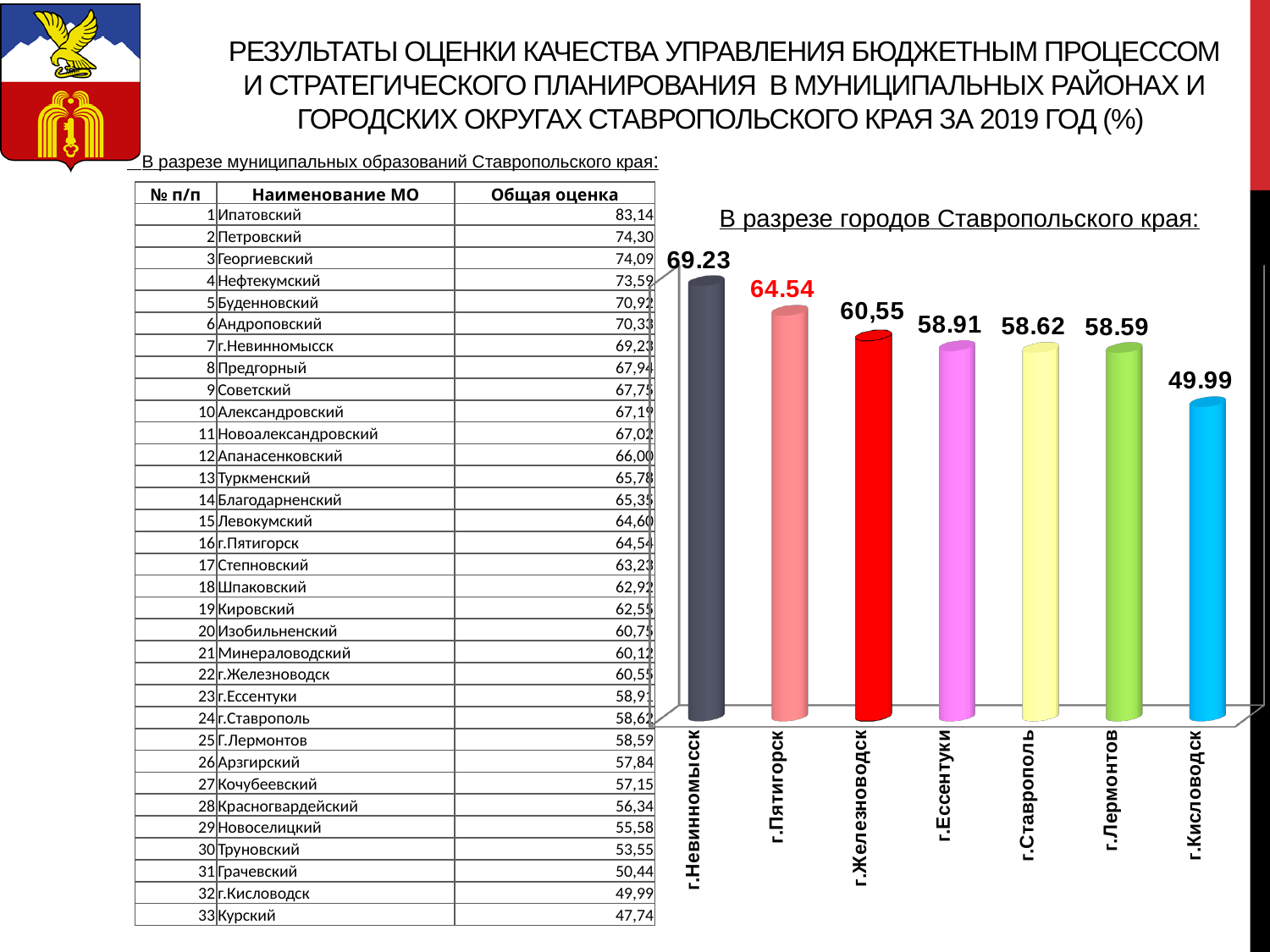
What is the value for г.Кисловодск? 49.99 Which is larger, the value for г.Пятигорск or the value for г.Железноводск? г.Пятигорск What is the difference between the values for г.Невинномысск and г.Кисловодск? 19.24 What is the value for г.Пятигорск? 64.54 Do the values rise or fall from left to right across the chart? fall Which city has the highest value in the chart? г.Невинномысск What kind of chart is shown on the slide? bar chart What is the difference between the values for г.Невинномысск and г.Пятигорск? 4.69 Which city has the lowest value in the chart? г.Кисловодск What is the value for г.Невинномысск? 69.23 How many cities are shown in the chart? 7 What is the value for г.Железноводск? 60,55